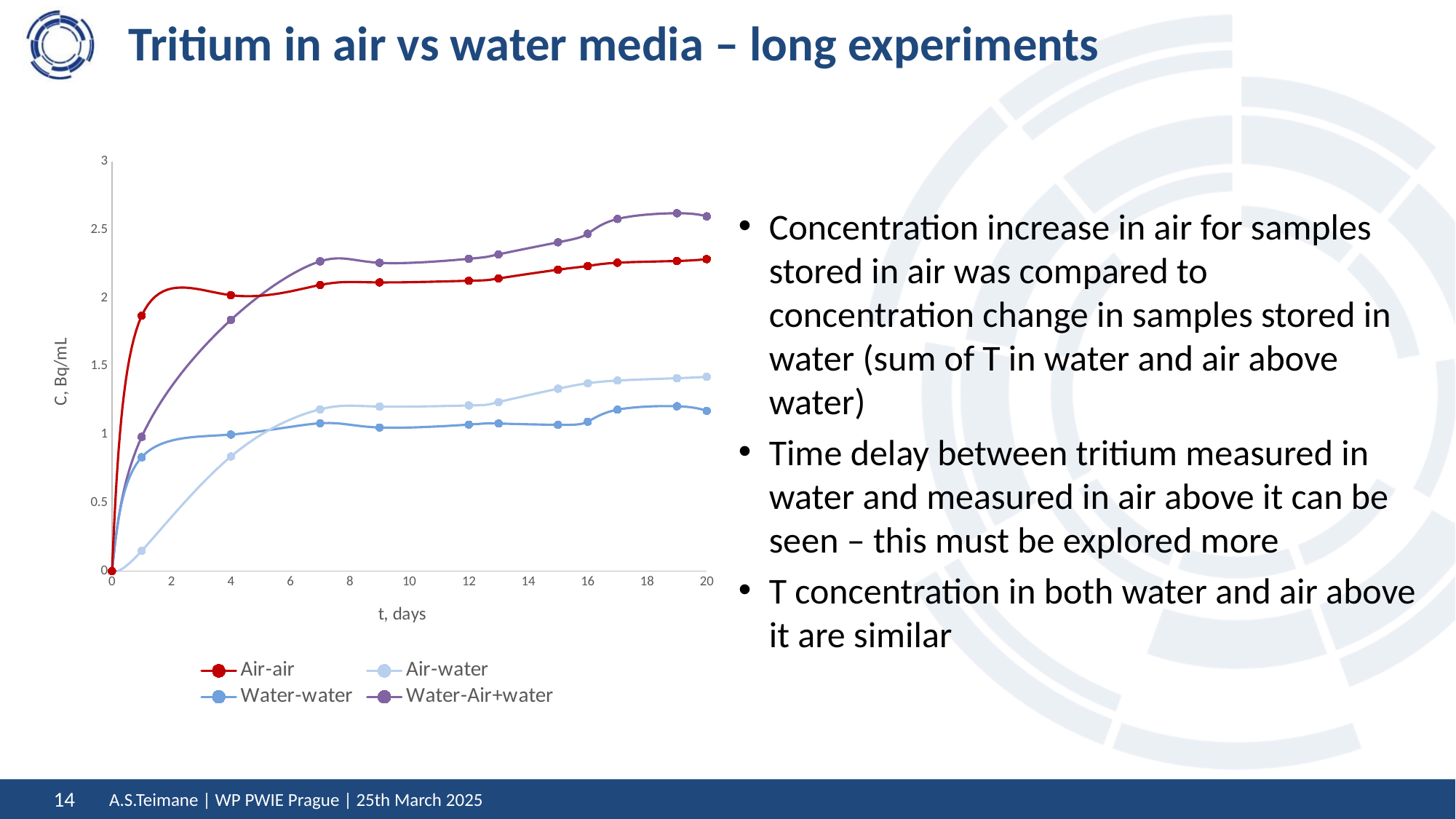
What kind of chart is shown on the slide? Line chart What is the label of the y axis of the chart? C, Bq/mL What is the label of the x axis of the chart? t, days Does the Air-water series rise or fall as t increases from 0 to 20 days? Rise Which series has the lowest value at 20 days? Water-water Is the value of the Air-air series at 20 days greater or less than 2? greater Is the value of the Water-Air+water series at 20 days greater or less than 2.5? greater At 1 day, which series has the larger value, Air-air or Water-Air+water? Air-air Is the value of the Air-water series at 1 day greater or less than 0.5? less At 20 days, which series has the larger value, Air-water or Water-water? Air-water How many series does the chart legend list? 4 Which series has the highest value at 20 days? Water-Air+water